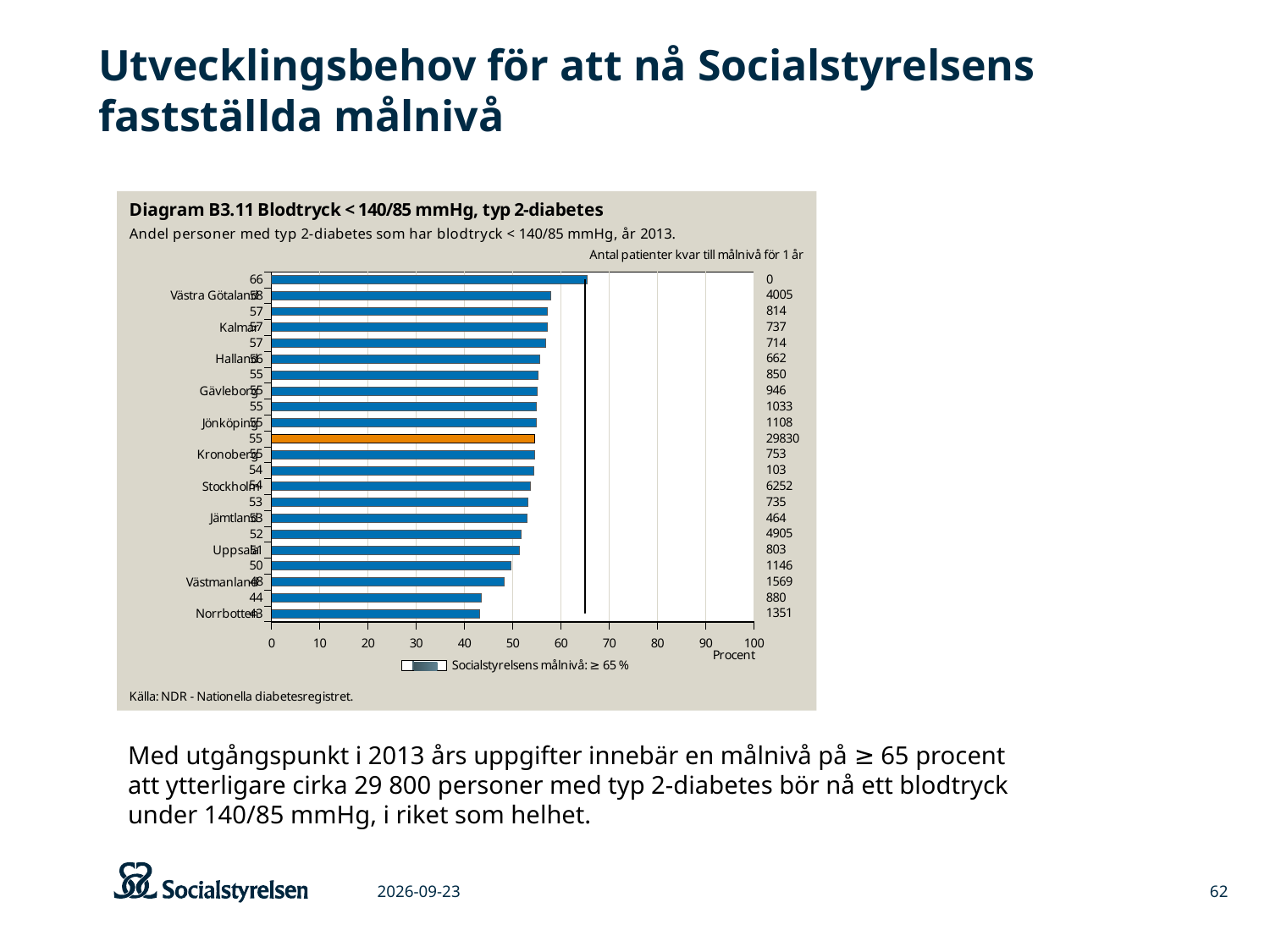
Is the value for Jämtland greater or less than 60? less What is the 'Antal patienter kvar till målnivå för 1 år' figure shown for Stockholm? 6252 How many bars are plotted in the chart? 22 What kind of chart is shown on the slide? bar chart Which has a higher value, Kalmar or Uppsala? Kalmar Which labelled region has the lowest value in the chart? Norrbotten What is the value for Västmanland in the chart? 48 What target level (Socialstyrelsens målnivå) does the legend state? ≥ 65 % What is the value for Stockholm in the chart? 54 What is the value for Norrbotten in the chart? 43 What is the value for Västra Götaland in the chart? 58 What is the difference between the values for Västra Götaland and Norrbotten? 15